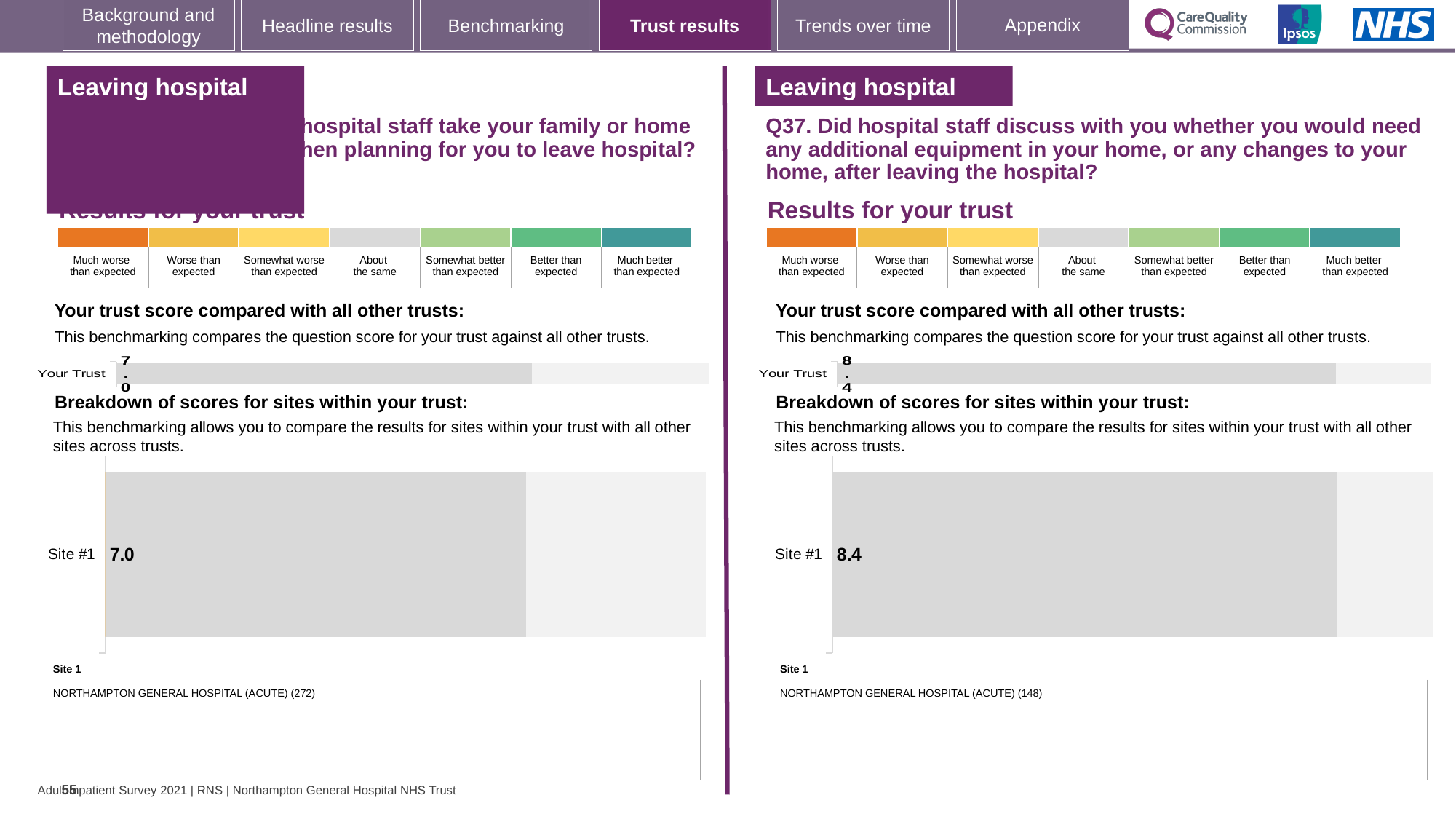
What type of chart is used to show the Site #1 score on the right half of the slide (Q37)? Bar chart On the right half of the slide (Q37), what is the score shown for Site #1? 8.4 On the left half of the slide, what is the score shown for Your Trust? 7.0 What is the difference between the Site #1 score on the right half (Q37) and the Site #1 score on the left half of the slide? 1.4 On the left half of the slide, what is the score shown for Site #1? 7.0 On the left half of the slide, which site is listed as Site 1? NORTHAMPTON GENERAL HOSPITAL (ACUTE) (272) On the right half of the slide (Q37), which site is listed as Site 1? NORTHAMPTON GENERAL HOSPITAL (ACUTE) (148) Which is larger: the Site #1 score on the left half of the slide or the Site #1 score on the right half (Q37)? Right half (Q37) On the right half of the slide (Q37), what is the score shown for Your Trust? 8.4 How many sites are shown in the 'Breakdown of scores for sites within your trust' chart on the left half of the slide? 1 How many sites are shown in the 'Breakdown of scores for sites within your trust' chart on the right half of the slide (Q37)? 1